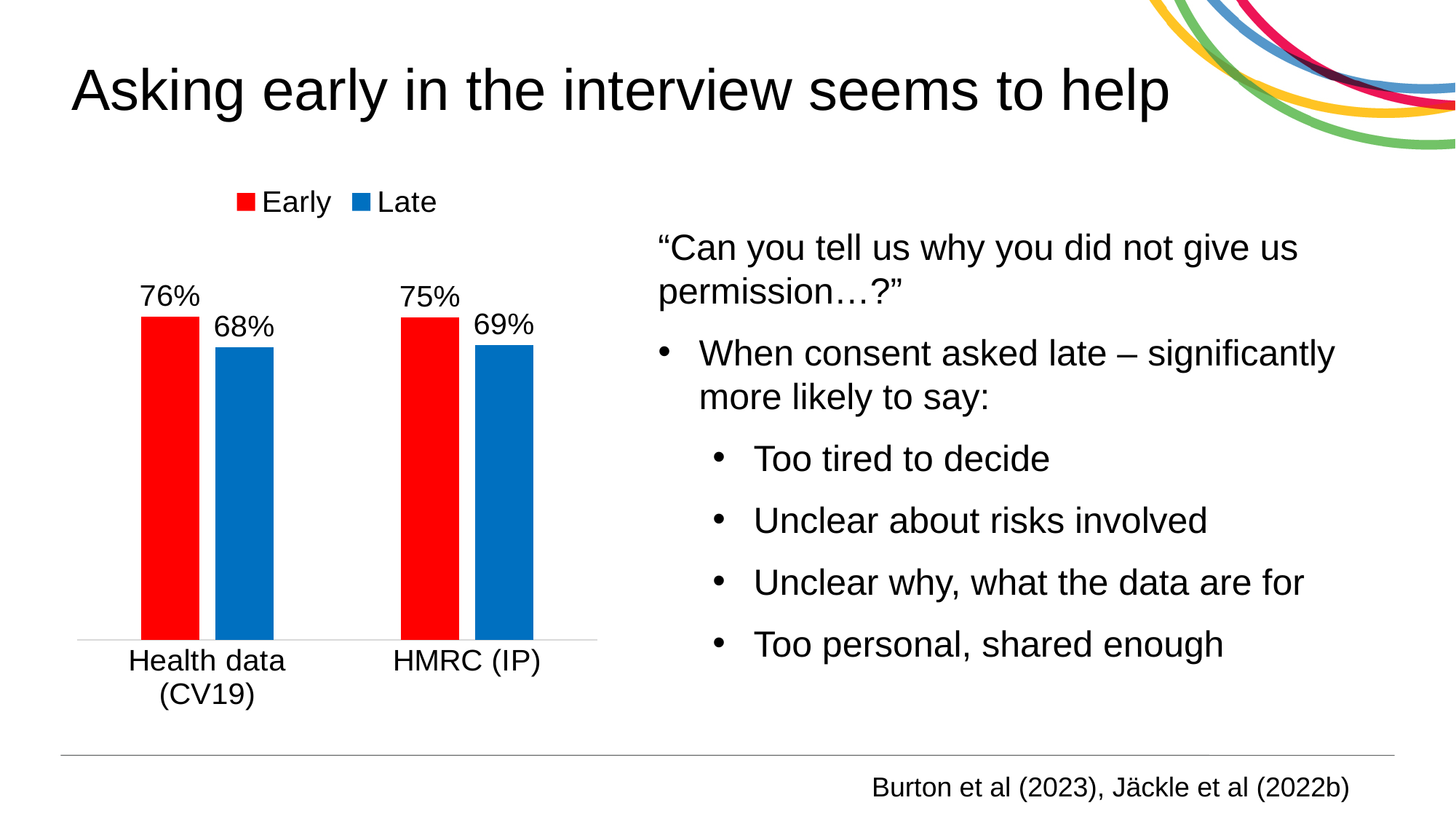
How many categories are shown on the x axis? 2 What is the Late value for Health data (CV19)? 68% What is the Late value for HMRC (IP)? 69% What is the difference between the Early and Late values for Health data (CV19)? 8% Which category has the lowest Late value? Health data (CV19) What is the Early value for HMRC (IP)? 75% What is the Early value for Health data (CV19)? 76% How many series does the legend list? 2 For HMRC (IP), which is larger, the Early or the Late value? Early What kind of chart is shown on the slide? Bar chart What is the difference between the Early and Late values for HMRC (IP)? 6% Which colour represents the Late series? Blue